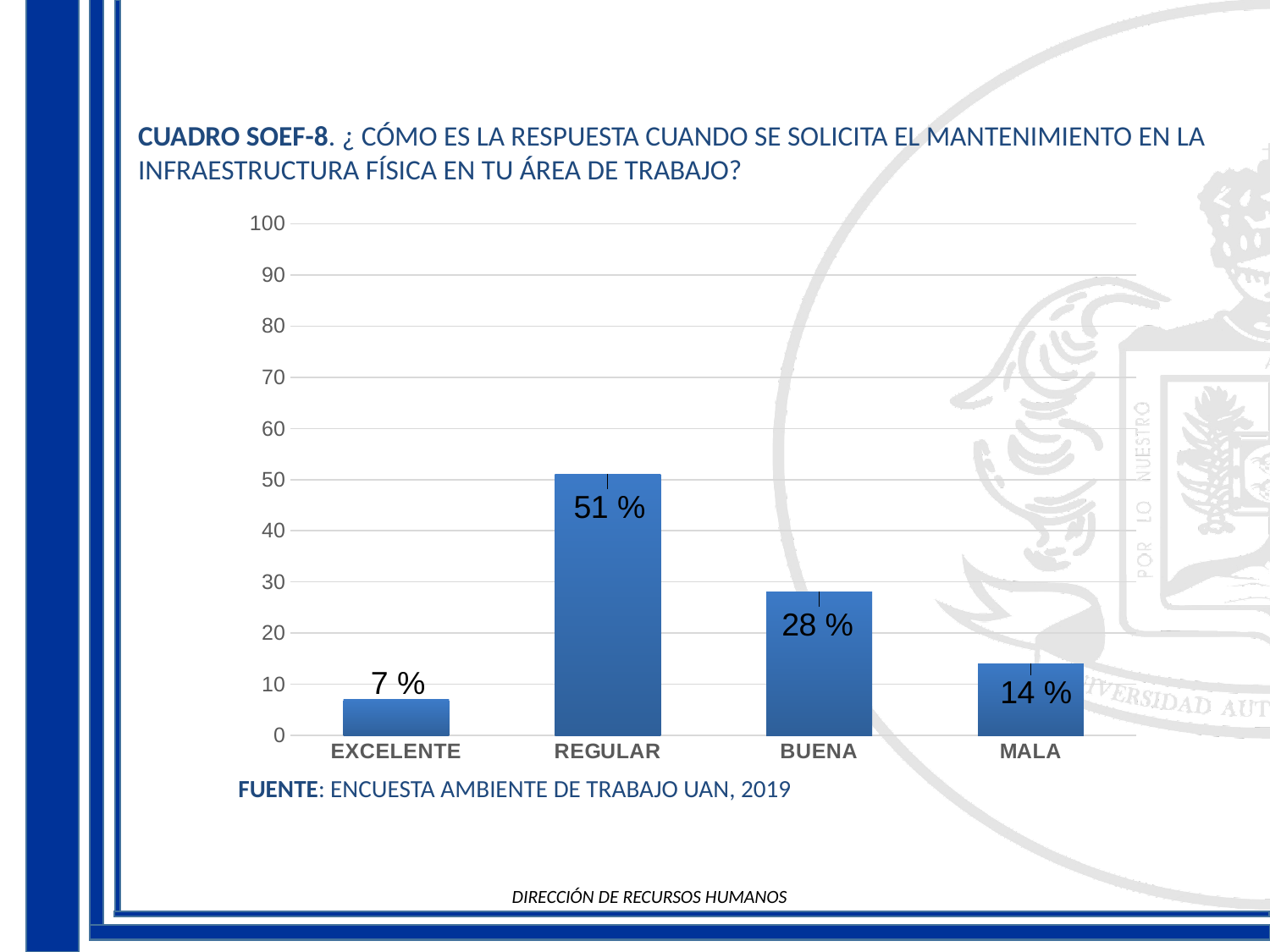
Which category has the highest value? REGULAR What is the value for REGULAR? 51 % What is the source cited below the chart? ENCUESTA AMBIENTE DE TRABAJO UAN, 2019 Which category has the lowest value? EXCELENTE How many categories are shown on the x axis? 4 What is the value for EXCELENTE? 7 % Which is larger, the value for BUENA or the value for MALA? BUENA What is the difference between the values for REGULAR and BUENA? 23 % What is the value for MALA? 14 % What kind of chart is shown on the slide? bar chart Is the value for BUENA greater or less than 20? greater What is the highest value shown on the y axis? 100